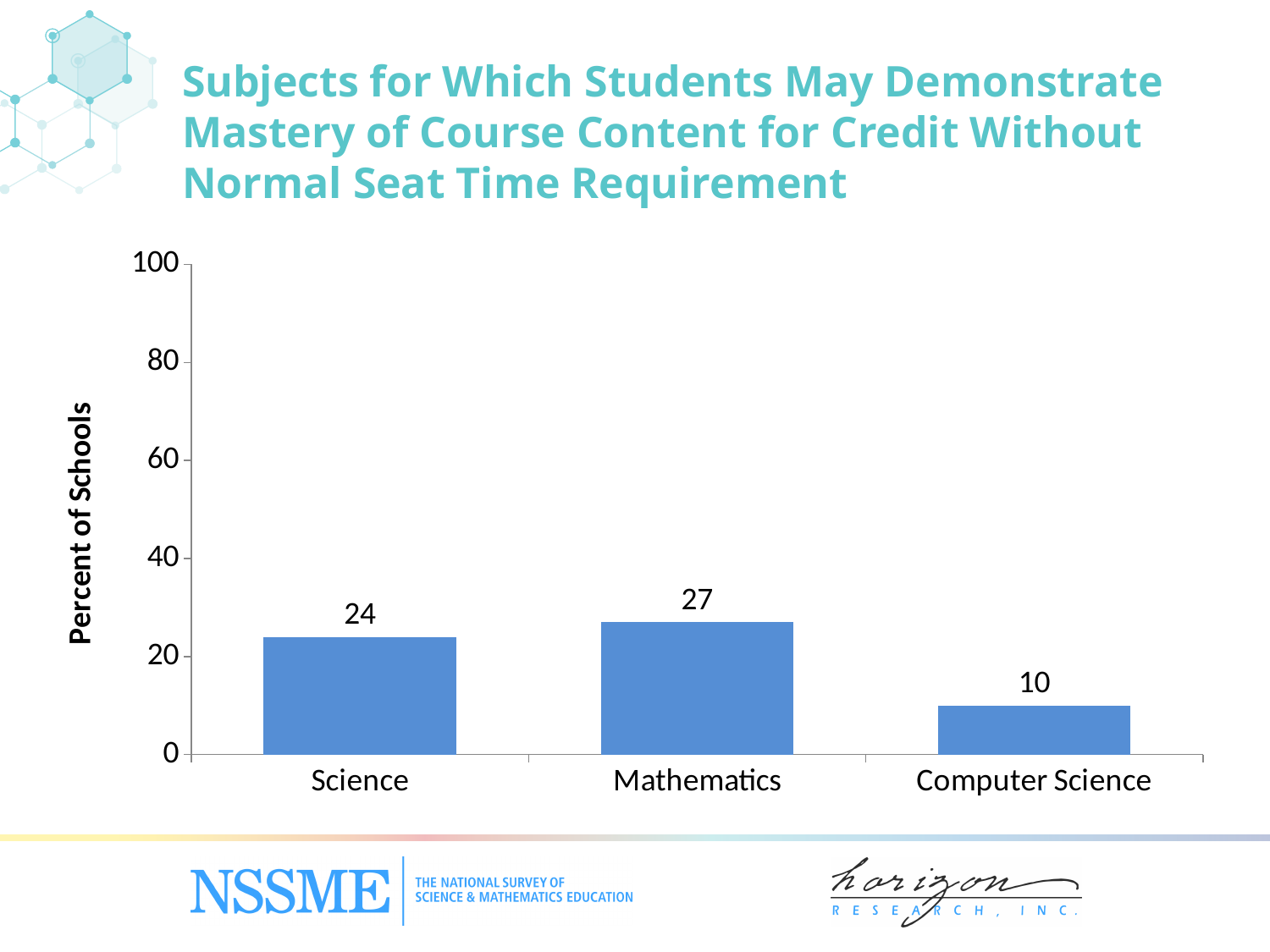
What is the value for Mathematics? 27 What is the value for Computer Science? 10 Which subject has the lowest percent of schools? Computer Science What is the difference between the values for Science and Computer Science? 14 Is the value for Mathematics greater or less than 40? less What is the difference between the values for Mathematics and Science? 3 What is the label on the vertical axis? Percent of Schools Which subject has the highest percent of schools? Mathematics What is the value for Science? 24 Which is larger, the value for Science or the value for Computer Science? Science How many subjects are shown on the chart? 3 What kind of chart is shown on the slide? bar chart